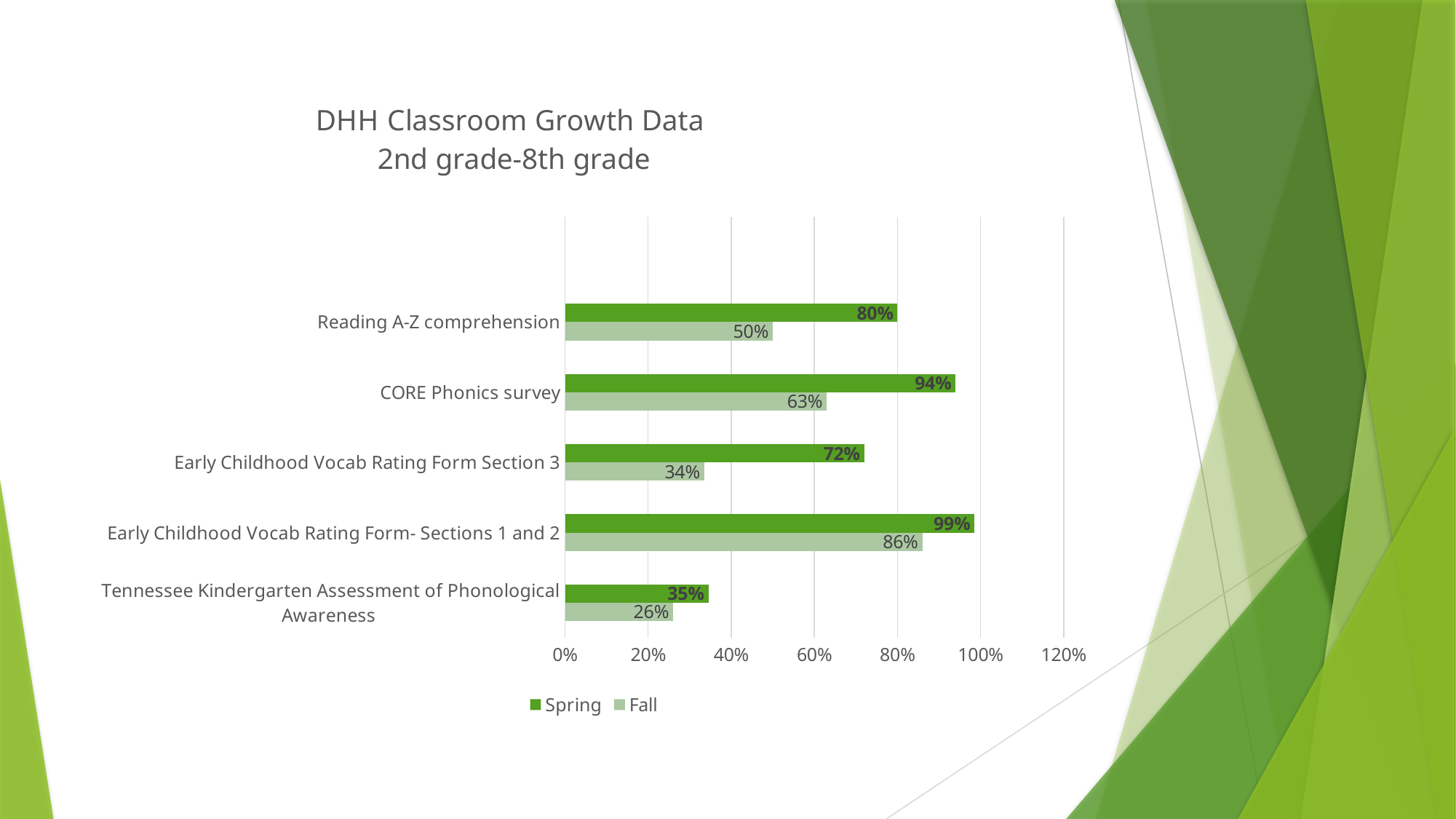
Which category has the lowest Fall value? Tennessee Kindergarten Assessment of Phonological Awareness Which is larger: the Spring value for CORE Phonics survey or the Spring value for Reading A-Z comprehension? CORE Phonics survey How many categories are shown on the chart? 5 Is the Fall value for Early Childhood Vocab Rating Form- Sections 1 and 2 greater or less than 80%? greater What is the difference between the Spring and Fall values for Early Childhood Vocab Rating Form Section 3? 38% What is the Fall value for Early Childhood Vocab Rating Form Section 3? 34% Which category has the highest Spring value? Early Childhood Vocab Rating Form- Sections 1 and 2 What is the Fall value for CORE Phonics survey? 63% What is the Spring value for Reading A-Z comprehension? 80% What is the title of the chart? DHH Classroom Growth Data 2nd grade-8th grade How many series does the legend list? 2 What kind of chart is shown on the slide? bar chart